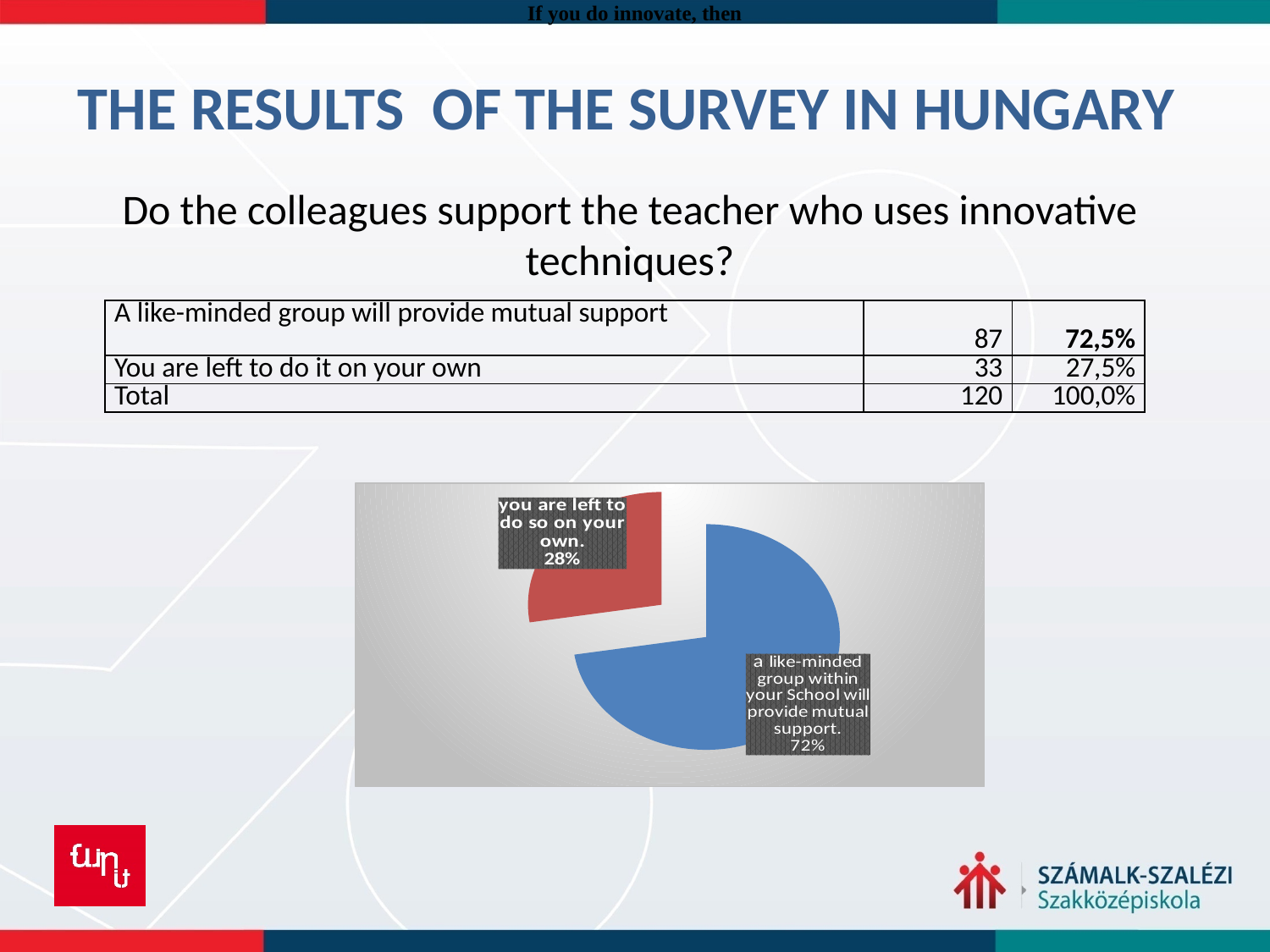
By how many percentage points does the "like-minded group" slice exceed the "left to do so on your own" slice in the pie chart? 44 What colour is the slice for "a like-minded group within your School will provide mutual support" in the pie chart? blue Which slice of the pie chart is the largest? a like-minded group within your School will provide mutual support What colour is the slice for "you are left to do so on your own" in the pie chart? red What percentage does the pie chart show for "you are left to do so on your own"? 28% Which slice of the pie chart is the smallest? you are left to do so on your own Is the share for "you are left to do so on your own" greater or less than 50%? less How many slices does the pie chart have? 2 What percentage does the pie chart show for "a like-minded group within your School will provide mutual support"? 72% What kind of chart is shown on the slide? pie chart Which is larger in the pie chart: the "like-minded group" slice or the "left to do so on your own" slice? a like-minded group within your School will provide mutual support